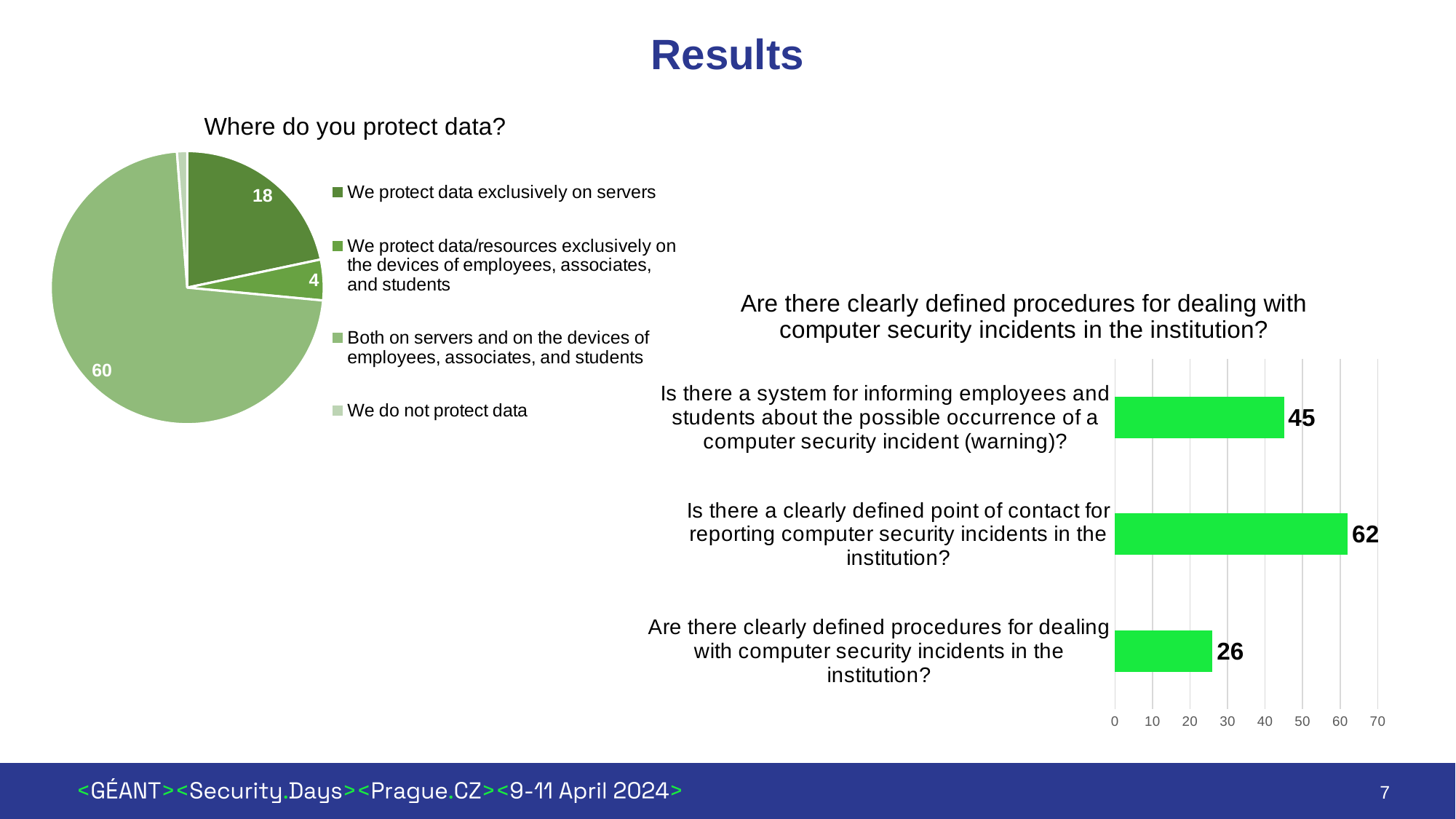
In the pie chart 'Where do you protect data?', what is the difference between the values for 'Both on servers and on the devices of employees, associates, and students' and 'We protect data exclusively on servers'? 42 In the pie chart 'Where do you protect data?', what value is shown for 'We protect data exclusively on servers'? 18 In the bar chart on the right, what is the difference between the values for the point of contact question and the warning system question? 17 What kind of chart is the chart on the right of the slide? bar chart In the bar chart on the right, what is the value for 'Are there clearly defined procedures for dealing with computer security incidents in the institution?'? 26 In the pie chart 'Where do you protect data?', which category has the largest slice? Both on servers and on the devices of employees, associates, and students In the pie chart 'Where do you protect data?', what value is shown for 'Both on servers and on the devices of employees, associates, and students'? 60 In the bar chart on the right, what is the value for 'Is there a clearly defined point of contact for reporting computer security incidents in the institution?'? 62 In the bar chart on the right, which category has the lowest value? Are there clearly defined procedures for dealing with computer security incidents in the institution? In the pie chart 'Where do you protect data?', what value is shown for 'We protect data/resources exclusively on the devices of employees, associates, and students'? 4 In the bar chart on the right, is the value for 'Is there a system for informing employees and students about the possible occurrence of a computer security incident (warning)?' greater or less than 40? greater In the pie chart 'Where do you protect data?', how many categories does the legend list? 4